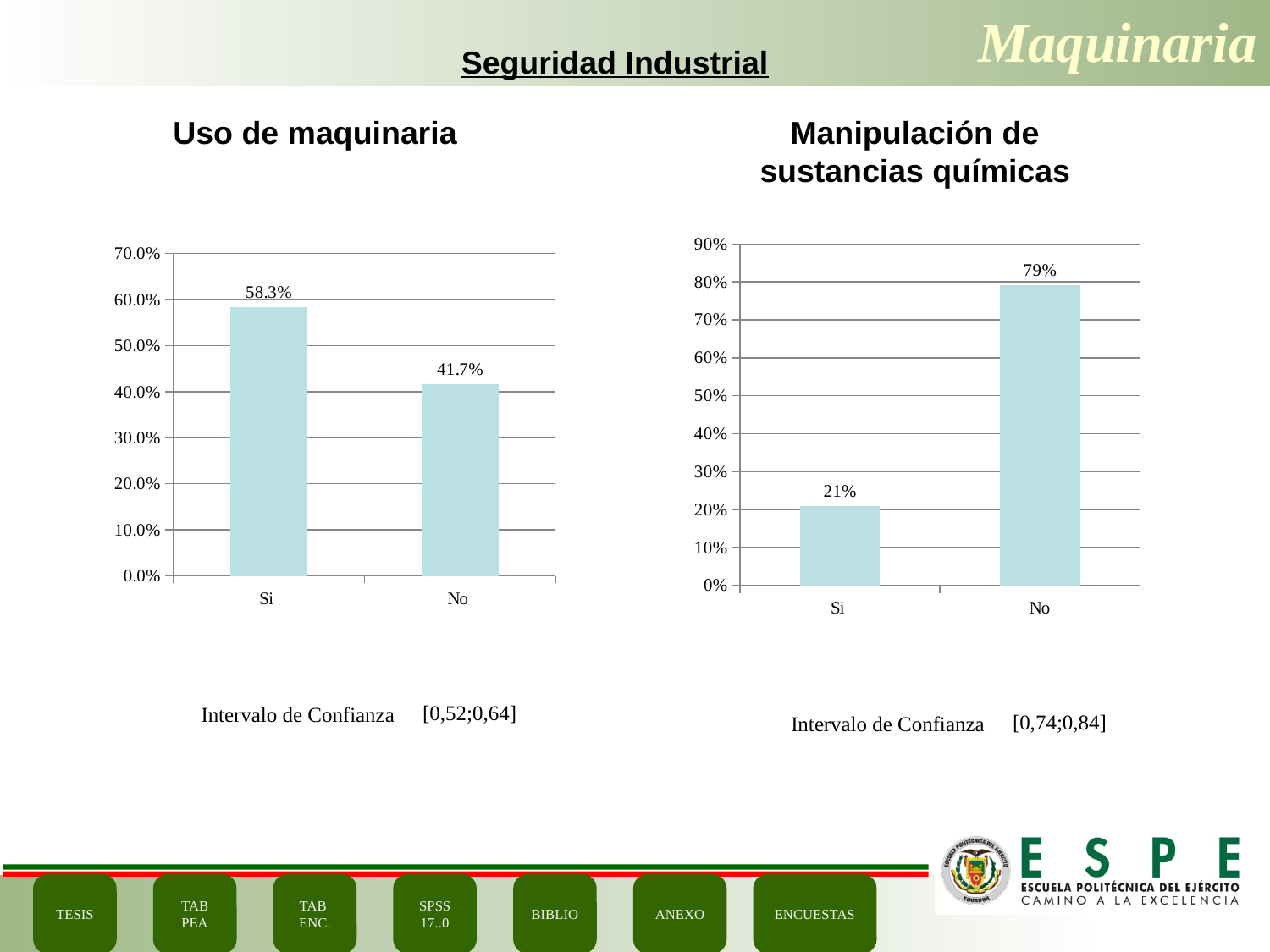
In the 'Uso de maquinaria' chart, what is the difference between the values for Si and No? 16.6% In the 'Manipulación de sustancias químicas' chart, what is the value for Si? 21% What kind of chart is the 'Uso de maquinaria' chart? bar chart In the 'Uso de maquinaria' chart, what is the value for No? 41.7% In the 'Manipulación de sustancias químicas' chart, what is the difference between the values for No and Si? 58% In the 'Uso de maquinaria' chart, what is the value for Si? 58.3% In the 'Uso de maquinaria' chart, is the value for No greater or less than 50.0%? less In the 'Uso de maquinaria' chart, which category has the highest value? Si In the 'Manipulación de sustancias químicas' chart, which category has the lowest value? Si In the 'Manipulación de sustancias químicas' chart, what is the value for No? 79% In the 'Manipulación de sustancias químicas' chart, which is larger, the value for Si or the value for No? No How many categories are shown in the 'Manipulación de sustancias químicas' chart? 2